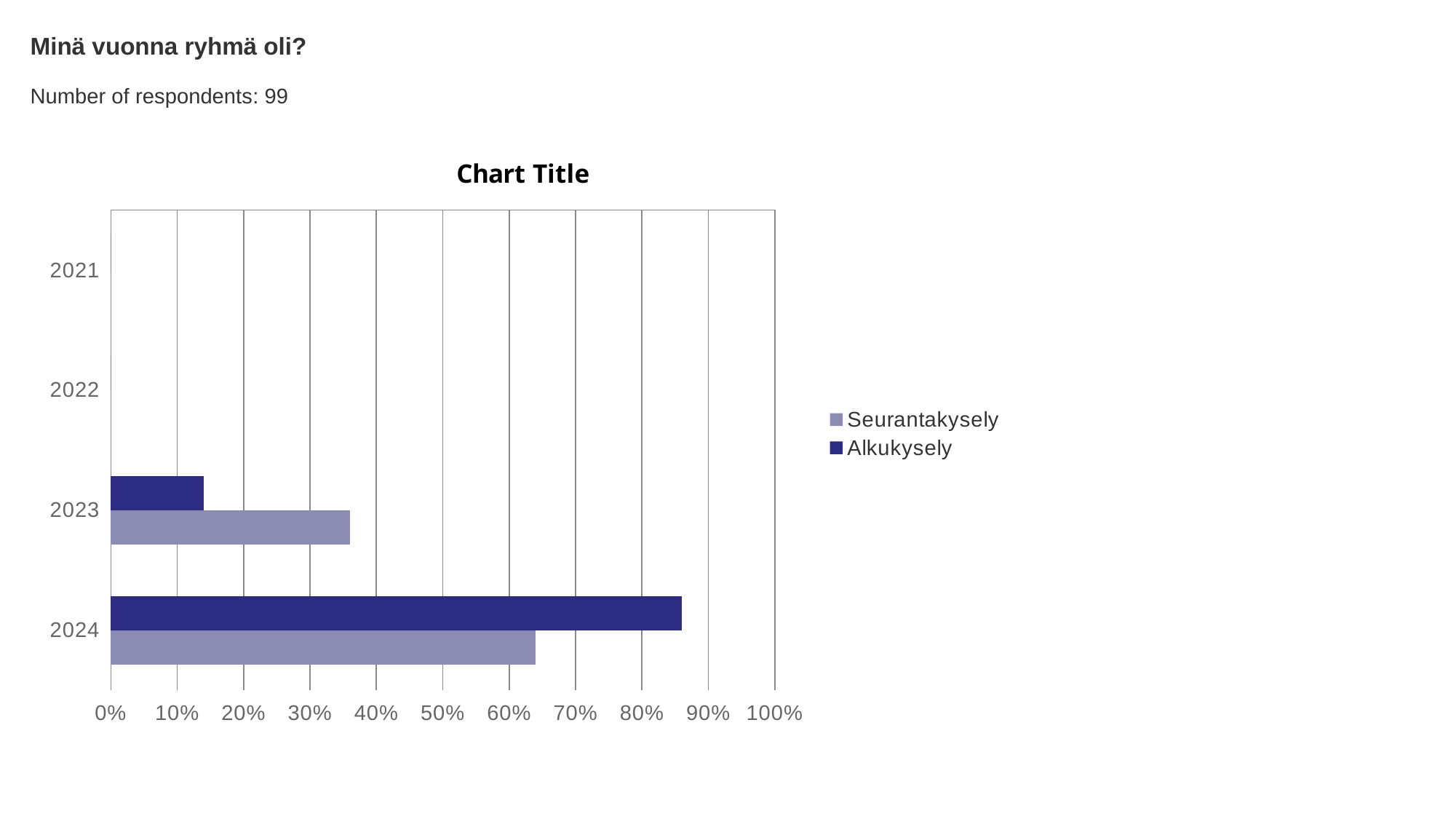
Is the Seurantakysely value for 2024 greater or less than 70%? less What kind of chart is shown on the slide? bar chart Is the Alkukysely value for 2023 greater or less than 20%? less Is the Seurantakysely value for 2023 greater or less than 30%? greater How many series does the legend list? 2 For 2023, which series has the larger value, Seurantakysely or Alkukysely? Seurantakysely How many year categories are shown on the vertical axis? 4 What is the title shown above the chart? Chart Title Which year has the highest Seurantakysely value? 2024 For 2024, which series has the larger value, Seurantakysely or Alkukysely? Alkukysely Which year has the highest Alkukysely value? 2024